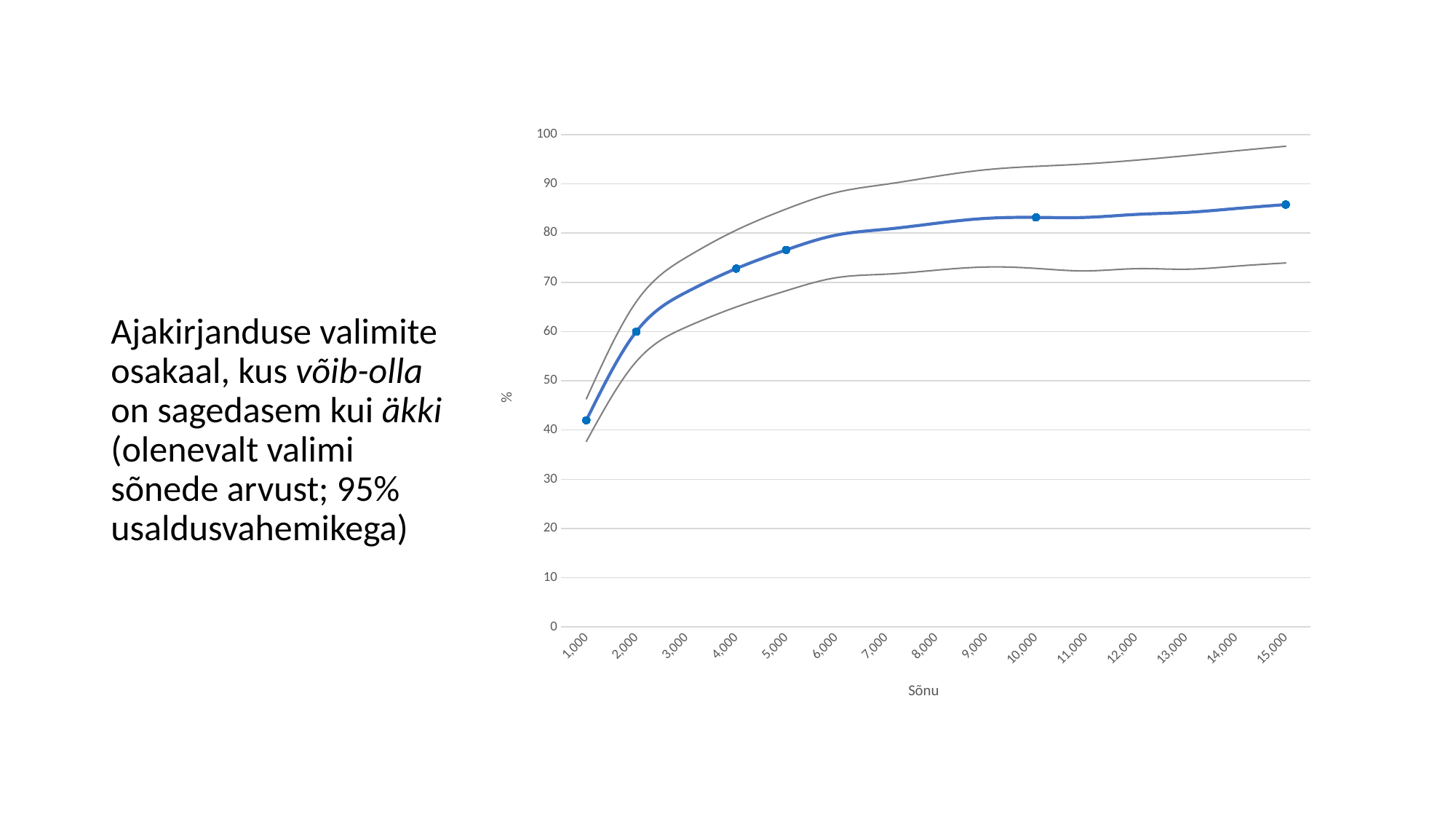
Which is larger: the blue line's value at 2,000 words or at 10,000 words? 10,000 words At which x-axis value does the blue line reach its highest marked point? 15,000 Does the blue line rise or fall as the number of words (Sõnu) increases along the x axis? rise Is the value of the blue line at 1,000 words greater or less than 50? less At which x-axis value does the blue line have its lowest marked point? 1,000 Is the value of the blue line at 4,000 words greater or less than 70? greater What is the label of the x axis? Sõnu What kind of chart is shown on the slide? line chart How many marked data points are on the blue line? 6 Is the value of the blue line at 15,000 words greater or less than 90? less